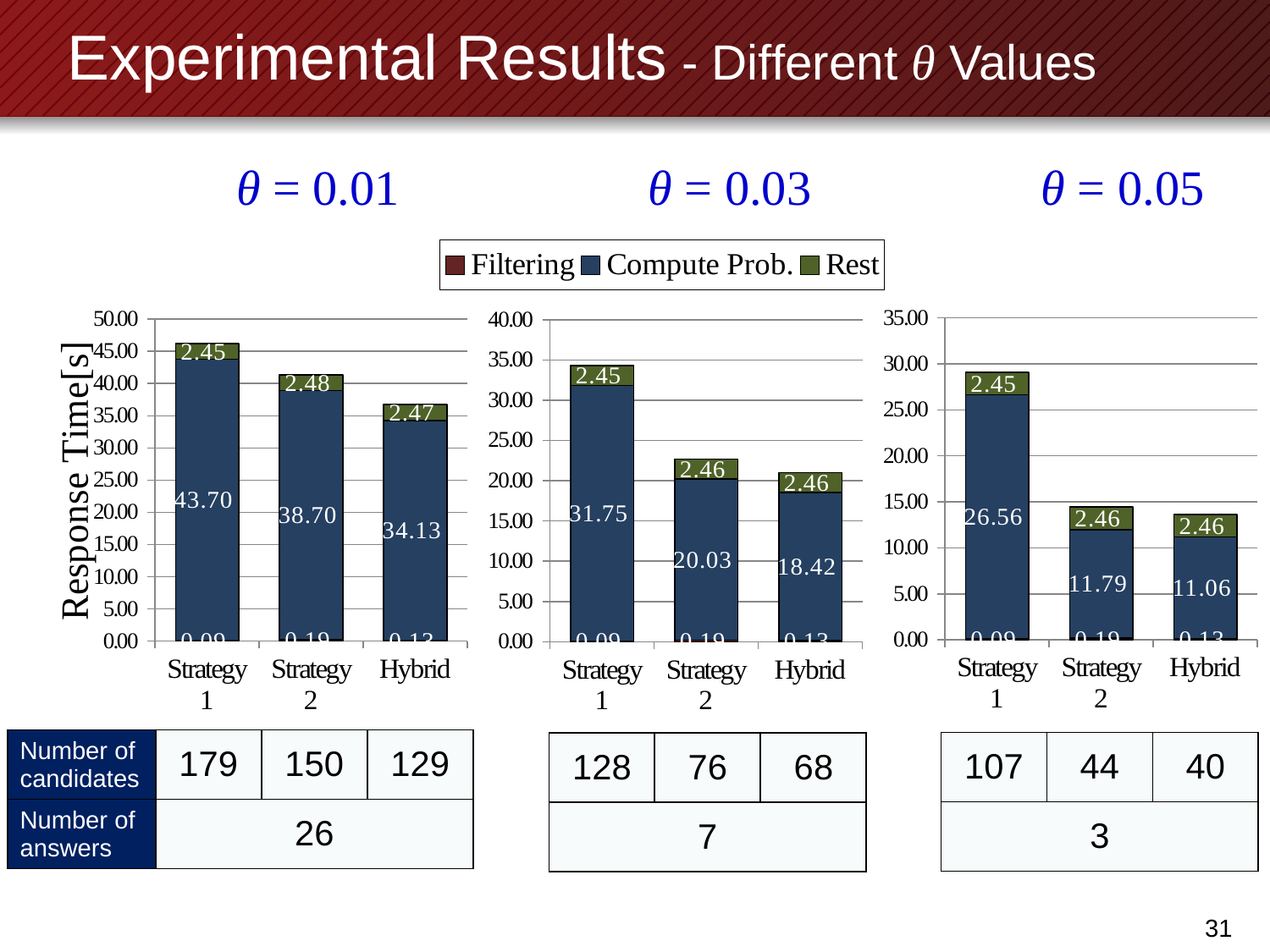
In the θ = 0.03 chart, which category has the highest Compute Prob. value? Strategy 1 In the θ = 0.03 chart, what is the Compute Prob. value for Hybrid? 18.42 In the θ = 0.01 chart, what is the Compute Prob. value for Strategy 1? 43.70 In the θ = 0.05 chart, is the total bar height for Strategy 1 greater or less than 25.00? greater In the θ = 0.05 chart, what is the Compute Prob. value for Strategy 1? 26.56 What kind of chart is used for the θ = 0.03 results? Stacked bar chart In the θ = 0.03 chart, what is the difference between the Compute Prob. values for Strategy 1 and Strategy 2? 11.72 In the θ = 0.05 chart, what is the difference between the Compute Prob. values for Strategy 2 and Hybrid? 0.73 How many series does the legend list for the charts? 3 In the θ = 0.01 chart, is the Compute Prob. value for Strategy 2 larger than that for Hybrid? Yes, Strategy 2 In the θ = 0.01 chart, which category has the lowest Compute Prob. value? Hybrid In the θ = 0.05 chart, what is the Rest value for Strategy 2? 2.46